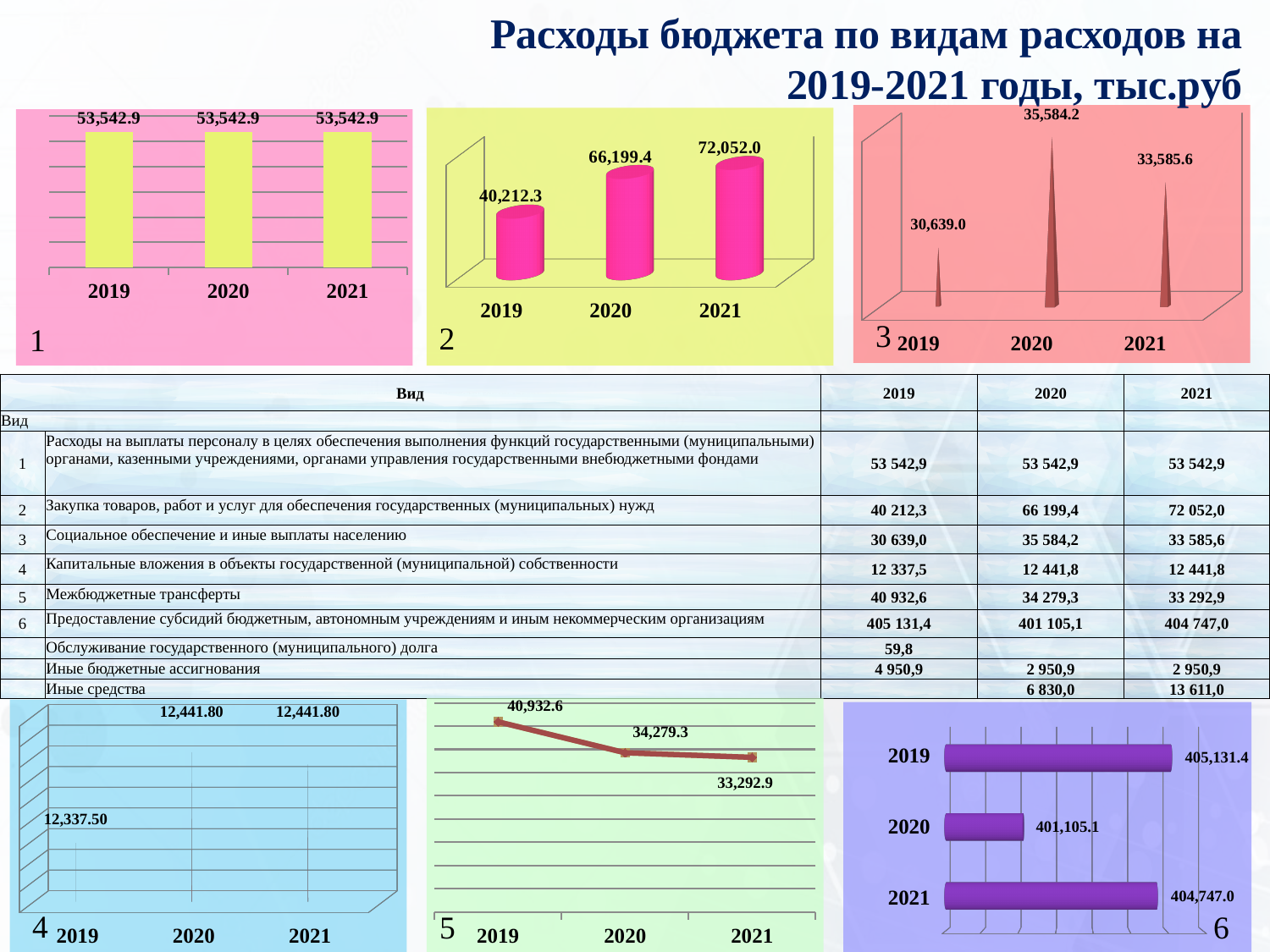
In chart 1 (top left, pink background), what is the value for 2020? 53,542.9 In chart 5 (bottom middle, green background), do the values rise or fall from 2019 to 2021? fall In chart 3 (top right, red background), what is the value for 2019? 30,639.0 In chart 6 (bottom right, purple background), which is larger: the value for 2020 or the value for 2021? 2021 In chart 6 (bottom right, purple background), which year has the highest value? 2019 In chart 3 (top right, red background), which year has the lowest value? 2019 In chart 2 (top middle, yellow background), what is the difference between the 2021 and 2020 values? 5,852.6 What kind of chart is chart 6 (bottom right, purple background)? bar chart In chart 5 (bottom middle, green background), what is the difference between the 2019 and 2021 values? 7,639.7 How many years are plotted in chart 1 (top left, pink background)? 3 In chart 5 (bottom middle, green background), what is the value for 2020? 34,279.3 In chart 2 (top middle, yellow background), what is the value for 2021? 72,052.0